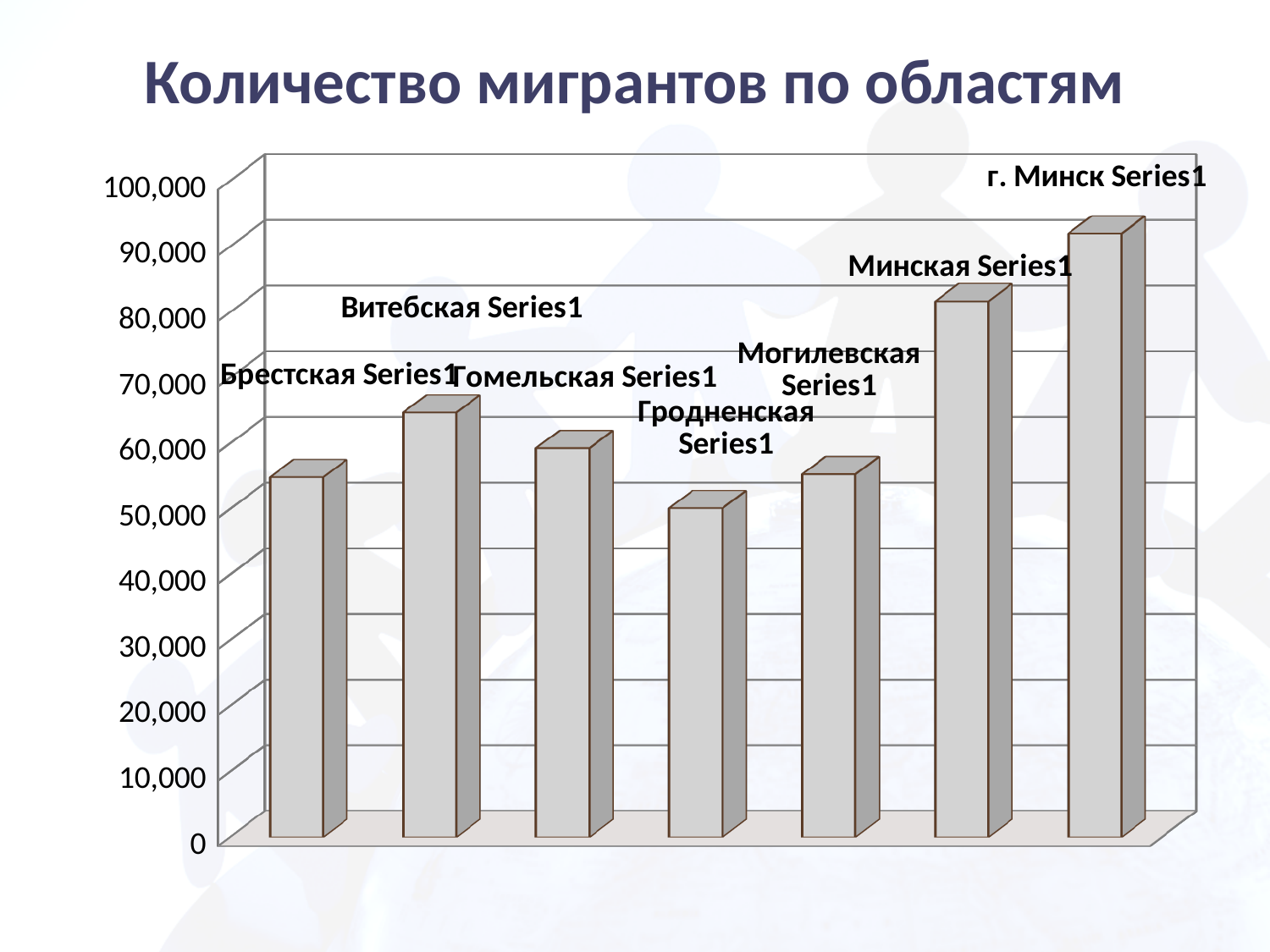
How many regions (bars) are shown in the chart? 7 Which region has the lowest number of migrants? Гродненская Is the value for Брестская greater or less than 50,000? greater Which has more migrants, Минская or Витебская? Минская Is the value for Витебская greater or less than 60,000? greater What is the title of the chart? Количество мигрантов по областям Is the value for г. Минск greater or less than 80,000? greater What kind of chart is shown on the slide? bar chart Which has more migrants, г. Минск or Минская? г. Минск Which has more migrants, Витебская or Гродненская? Витебская Which region has the highest number of migrants? г. Минск